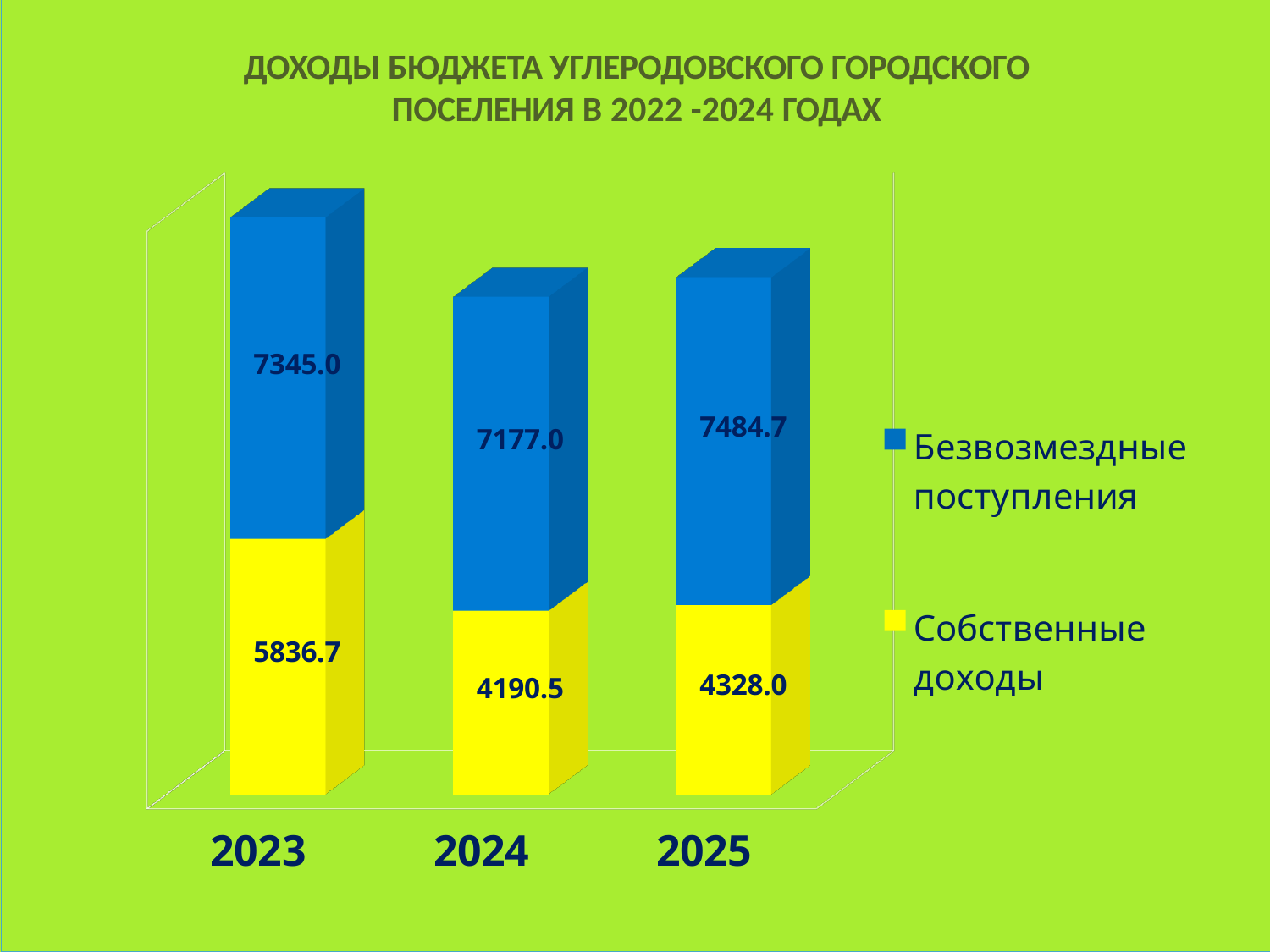
What is the difference between Собственные доходы in 2023 and 2024? 1646.2 What is the value of Безвозмездные поступления for 2023? 7345.0 In which year is Безвозмездные поступления lowest? 2024 How many series does the legend list? 2 What is the total of the stacked bar for 2023? 13181.7 How many years are shown on the x axis? 3 What is the value of Безвозмездные поступления for 2025? 7484.7 What kind of chart is shown on the slide? Stacked bar chart What is the value of Собственные доходы for 2024? 4190.5 In which year is Собственные доходы highest? 2023 What is the difference between Безвозмездные поступления in 2025 and 2024? 307.7 Which is larger: Собственные доходы in 2025 or in 2024? 2025